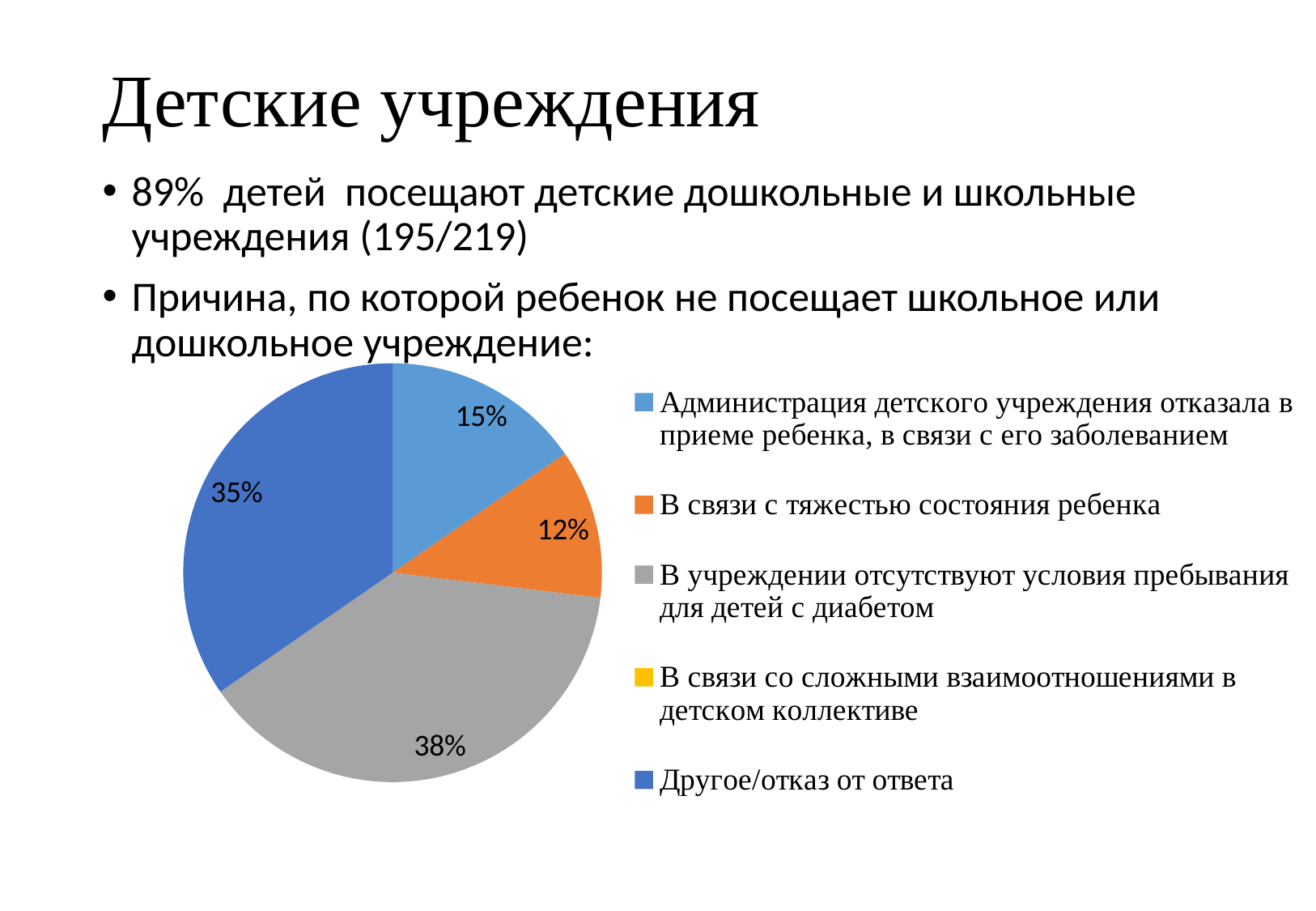
What share of the pie corresponds to "Другое/отказ от ответа"? 35% Which category has the largest slice of the pie? В учреждении отсутствуют условия пребывания для детей с диабетом What colour is the legend marker for "В связи со сложными взаимоотношениями в детском коллективе"? yellow What is the difference in percentage points between the "Другое/отказ от ответа" slice and the "В связи с тяжестью состояния ребенка" slice? 23 How many slices with printed percentage labels are visible in the pie chart? 4 What share of the pie corresponds to "В связи с тяжестью состояния ребенка"? 12% Among the slices with printed labels, which category has the smallest share? В связи с тяжестью состояния ребенка What share of the pie corresponds to "В учреждении отсутствуют условия пребывания для детей с диабетом"? 38% How many entries does the legend of the pie chart list? 5 What share of the pie corresponds to "Администрация детского учреждения отказала в приеме ребенка, в связи с его заболеванием"? 15% What kind of chart is shown on the slide? pie chart Which is larger: the share for "Администрация детского учреждения отказала в приеме ребенка, в связи с его заболеванием" or the share for "В связи с тяжестью состояния ребенка"? Администрация детского учреждения отказала в приеме ребенка, в связи с его заболеванием